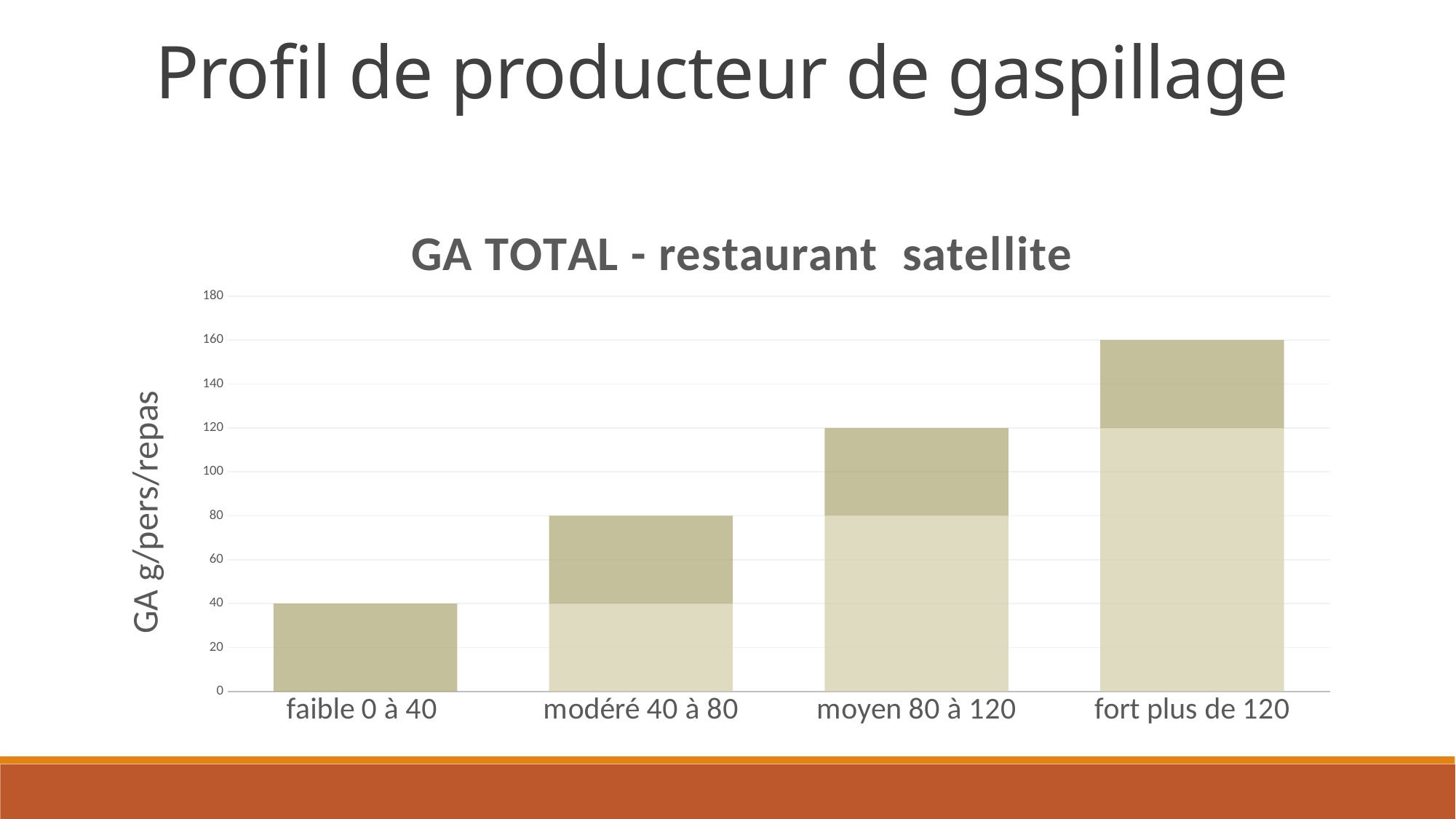
What is the total height of the bar for 'modéré 40 à 80'? 80 Do the bar heights rise or fall from left to right along the x axis? rise What is the total height of the bar for 'faible 0 à 40'? 40 How many categories are shown on the x axis of the chart? 4 What is the title of the chart? GA TOTAL - restaurant satellite What is the total height of the bar for 'fort plus de 120'? 160 What is the total height of the bar for 'moyen 80 à 120'? 120 Which is larger, the bar for 'moyen 80 à 120' or the bar for 'modéré 40 à 80'? moyen 80 à 120 What kind of chart is shown on the slide? bar chart Which category has the highest bar? fort plus de 120 What is the difference between the bar for 'fort plus de 120' and the bar for 'faible 0 à 40'? 120 Which category has the lowest bar? faible 0 à 40